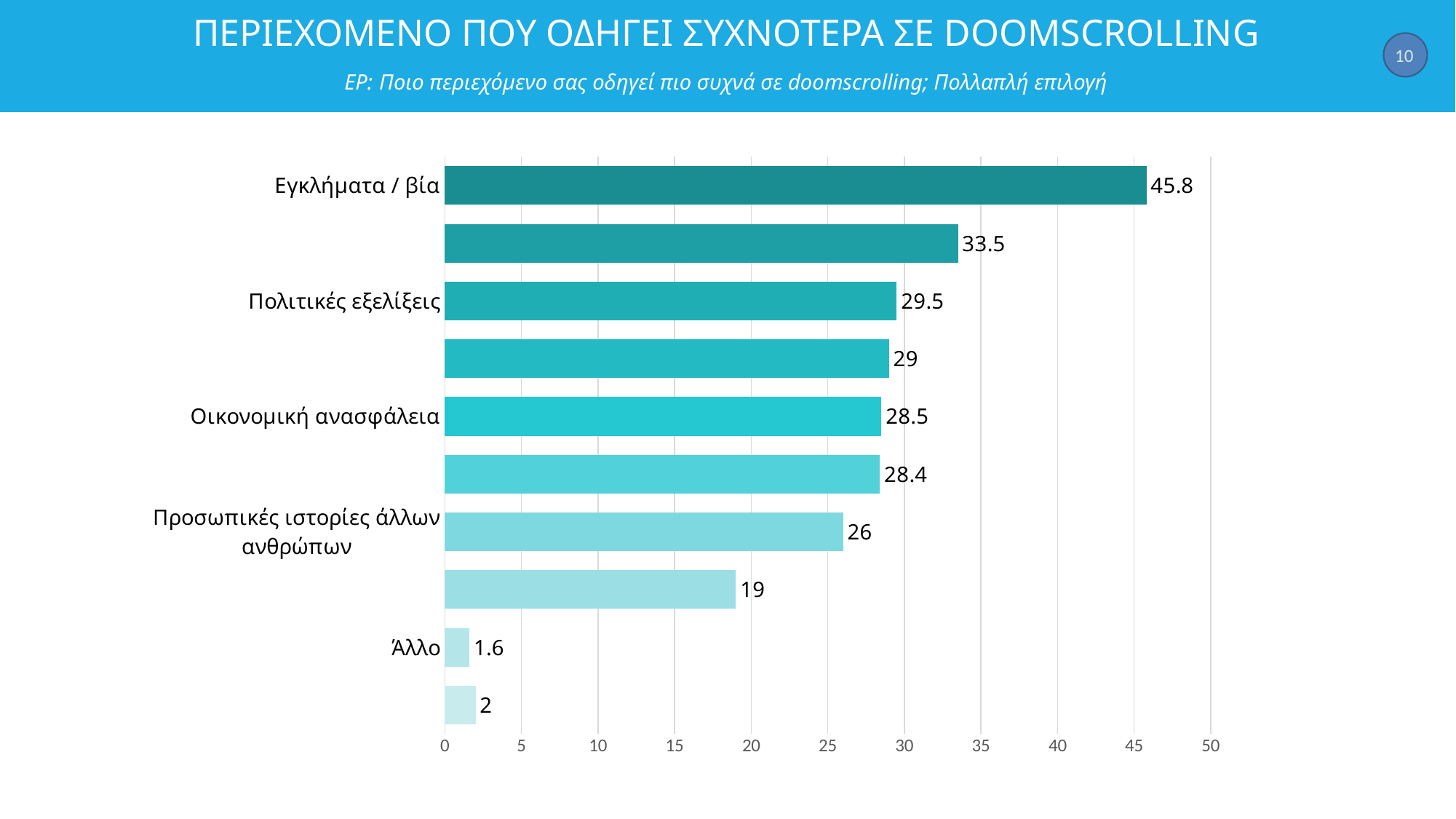
Which is larger, the value for Οικονομική ανασφάλεια or the value for Προσωπικές ιστορίες άλλων ανθρώπων? Οικονομική ανασφάλεια Which category has the highest value? Εγκλήματα / βία What is the value for Πολιτικές εξελίξεις? 29.5 What is the value for Οικονομική ανασφάλεια? 28.5 How many bars are plotted in the chart? 10 Is the value for Εγκλήματα / βία greater or less than 40? greater What is the difference between the values for Εγκλήματα / βία and Πολιτικές εξελίξεις? 16.3 What is the value for Προσωπικές ιστορίες άλλων ανθρώπων? 26 What is the value for Άλλο? 1.6 What kind of chart is shown on the slide? bar chart Which labelled category has the lowest value? Άλλο What is the value for Εγκλήματα / βία? 45.8